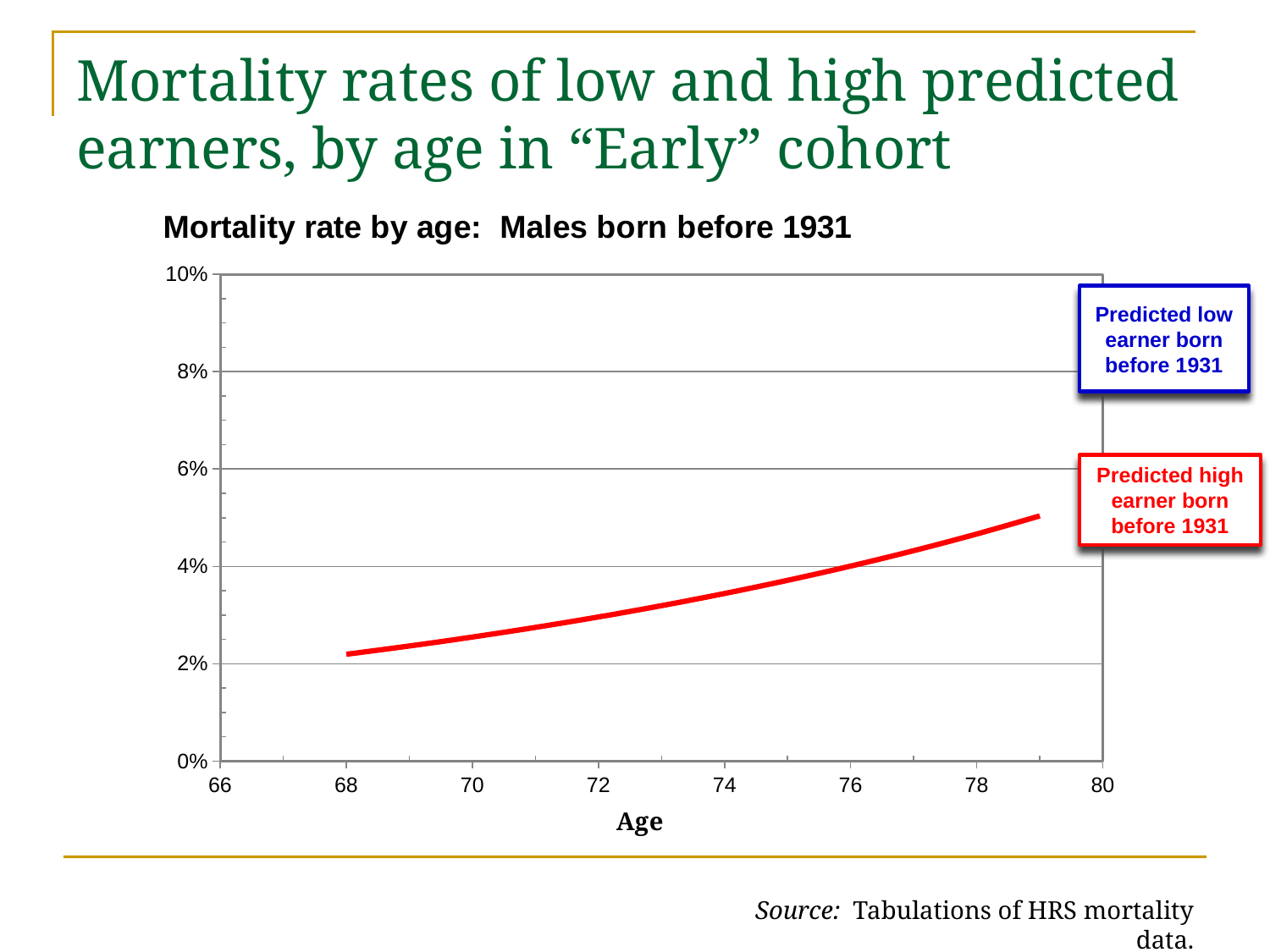
Does the plotted mortality rate rise or fall as age increases from 68 to 79? rise Is the mortality rate for the predicted high earner at age 79 greater or less than 6%? less Which is larger, the predicted high earner mortality rate at age 70 or at age 78? age 78 Is the mortality rate for the predicted high earner at age 72 greater or less than 4%? less What is the title of the chart? Mortality rate by age: Males born before 1931 What kind of chart is shown on the slide? line chart Is the mortality rate for the predicted high earner at age 79 greater or less than 4%? greater What is the highest value shown on the y axis? 10% What is the label of the x axis? Age